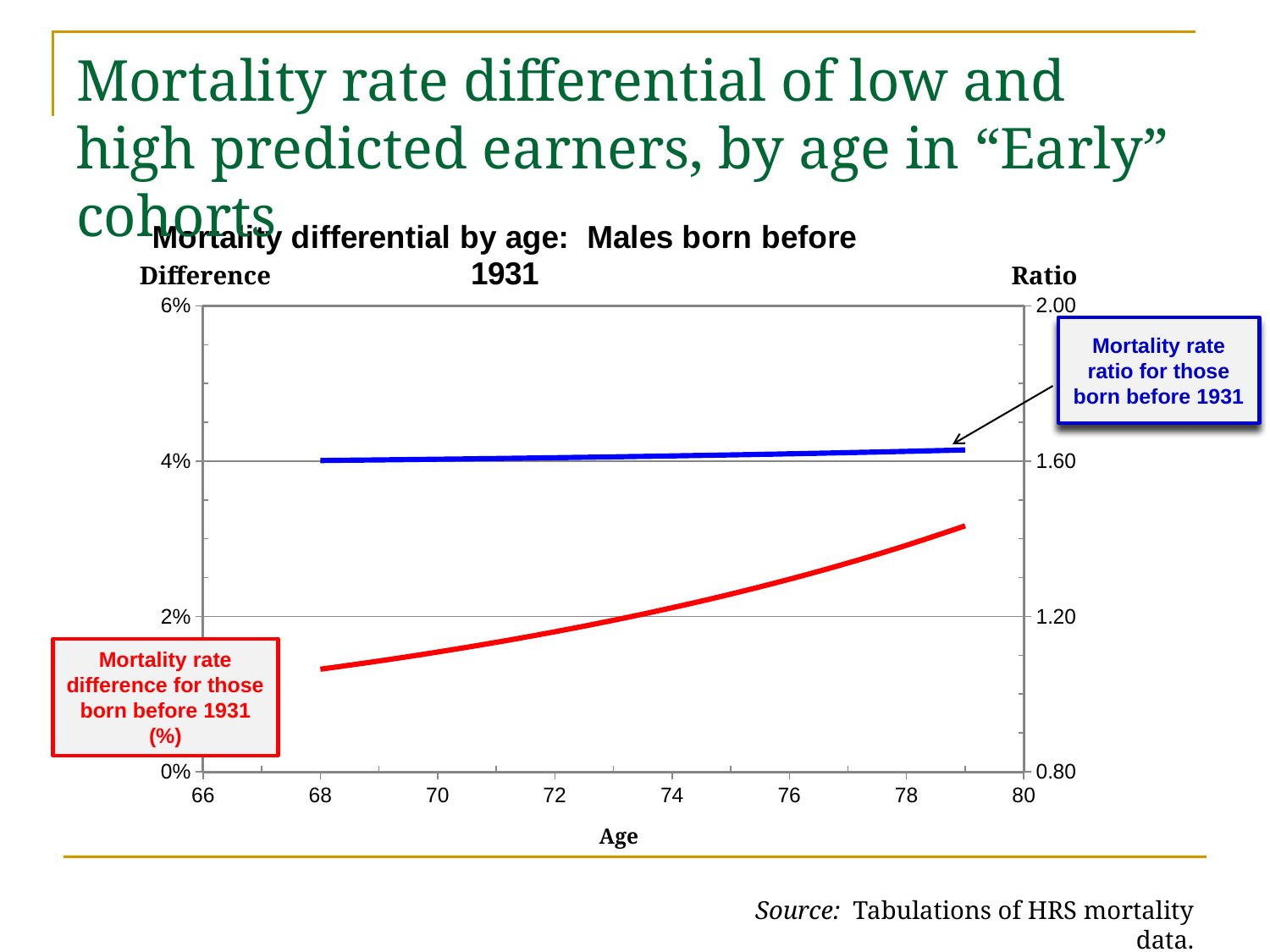
Is the mortality rate difference at age 79 greater or less than 2%? greater Is the mortality rate difference at age 68 greater or less than 2%? less What is the title of the chart? Mortality differential by age: Males born before 1931 What kind of chart is shown on the slide? Line chart What is the maximum value shown on the right-hand (Ratio) axis? 2.00 Which line is higher on the chart at age 70, the mortality rate difference (red) or the mortality rate ratio (blue)? Mortality rate ratio (blue) What is the label of the x axis of the chart? Age Is the mortality rate ratio at age 74 greater or less than 1.20? greater Does the mortality rate difference (red line) rise or fall as age increases? Rises How many lines are plotted on the chart? 2